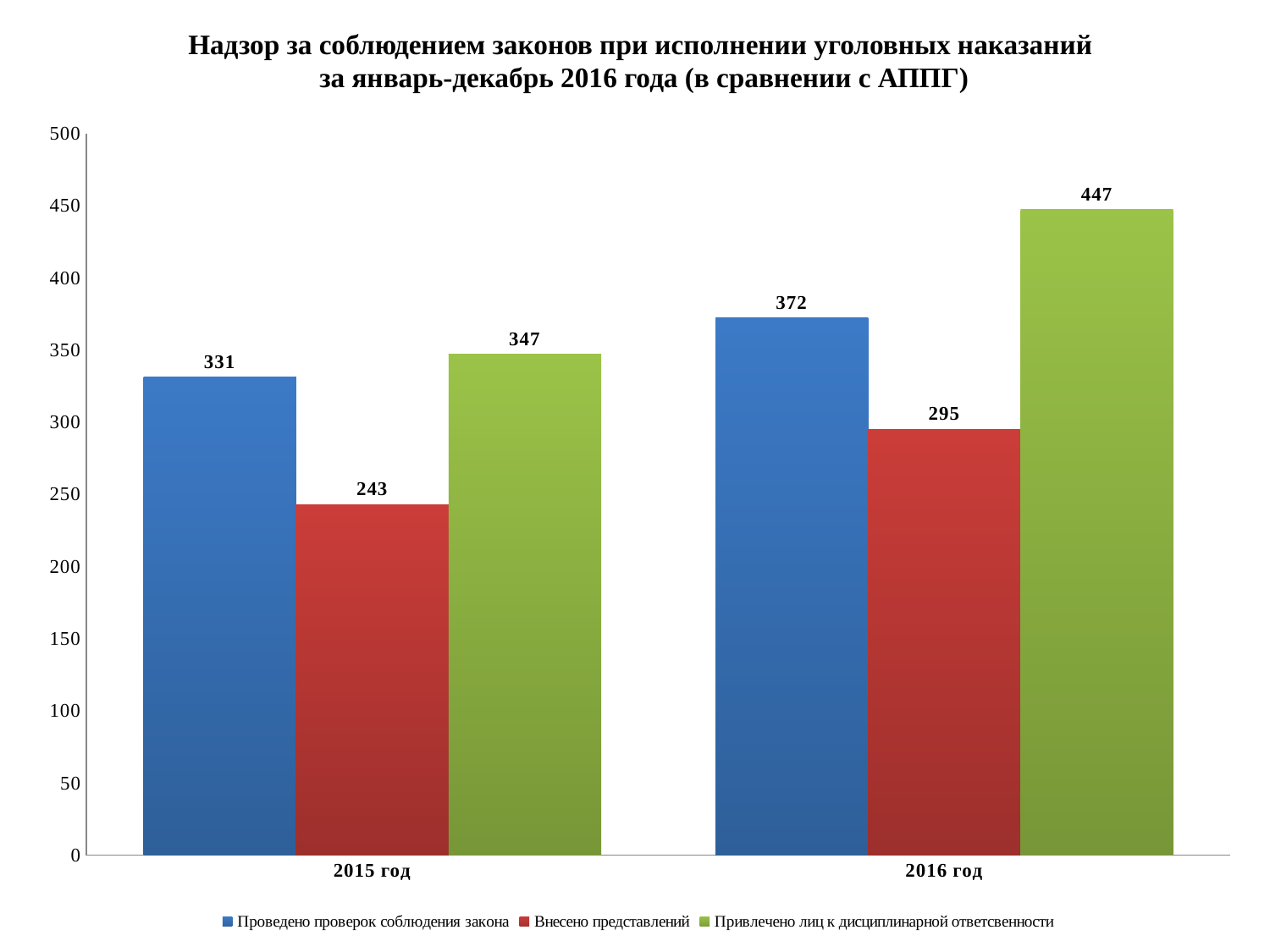
What value is shown for "Проведено проверок соблюдения закона" in 2015 год? 331 What value is shown for "Внесено представлений" in 2016 год? 295 Which series has the lowest value in 2015 год? Внесено представлений Which series has the highest value in 2016 год? Привлечено лиц к дисциплинарной ответсвенности Does the value for "Проведено проверок соблюдения закона" rise or fall from 2015 год to 2016 год? Rise What is the difference between the "Проведено проверок соблюдения закона" values for 2016 год and 2015 год? 41 How many categories are shown on the x axis? 2 What value is shown for "Привлечено лиц к дисциплинарной ответсвенности" in 2015 год? 347 What is the difference between the "Привлечено лиц к дисциплинарной ответсвенности" values for 2016 год and 2015 год? 100 Which is larger: "Внесено представлений" in 2015 год or in 2016 год? 2016 год What kind of chart is shown on the slide? Bar chart How many series does the legend list? 3